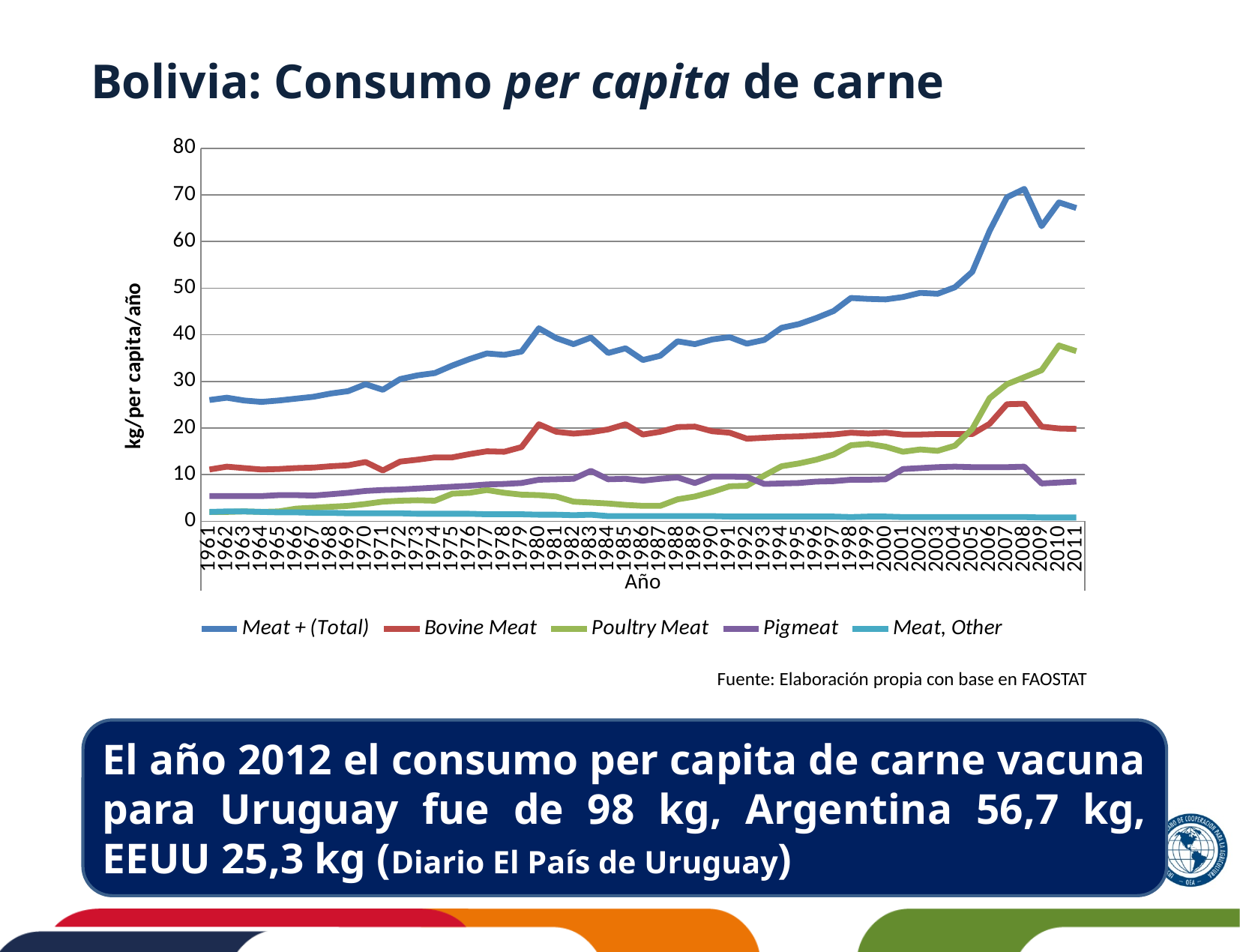
Which series has the lowest values across the whole period? Meat, Other How many series does the legend list? 5 Does the Meat + (Total) series generally rise or fall from 1961 to 2011? Rise In 2011, which is larger, Poultry Meat or Bovine Meat? Poultry Meat Is the value for Pigmeat in 2011 greater or less than 10? less What kind of chart is shown on the slide? Line chart Is the value for Poultry Meat in 2010 greater or less than 30? greater How many years are plotted along the x axis? 51 Is the value for Bovine Meat in 1961 greater or less than 20? less In 1961, which is larger, Bovine Meat or Poultry Meat? Bovine Meat What is the label of the y axis? kg/per capita/año